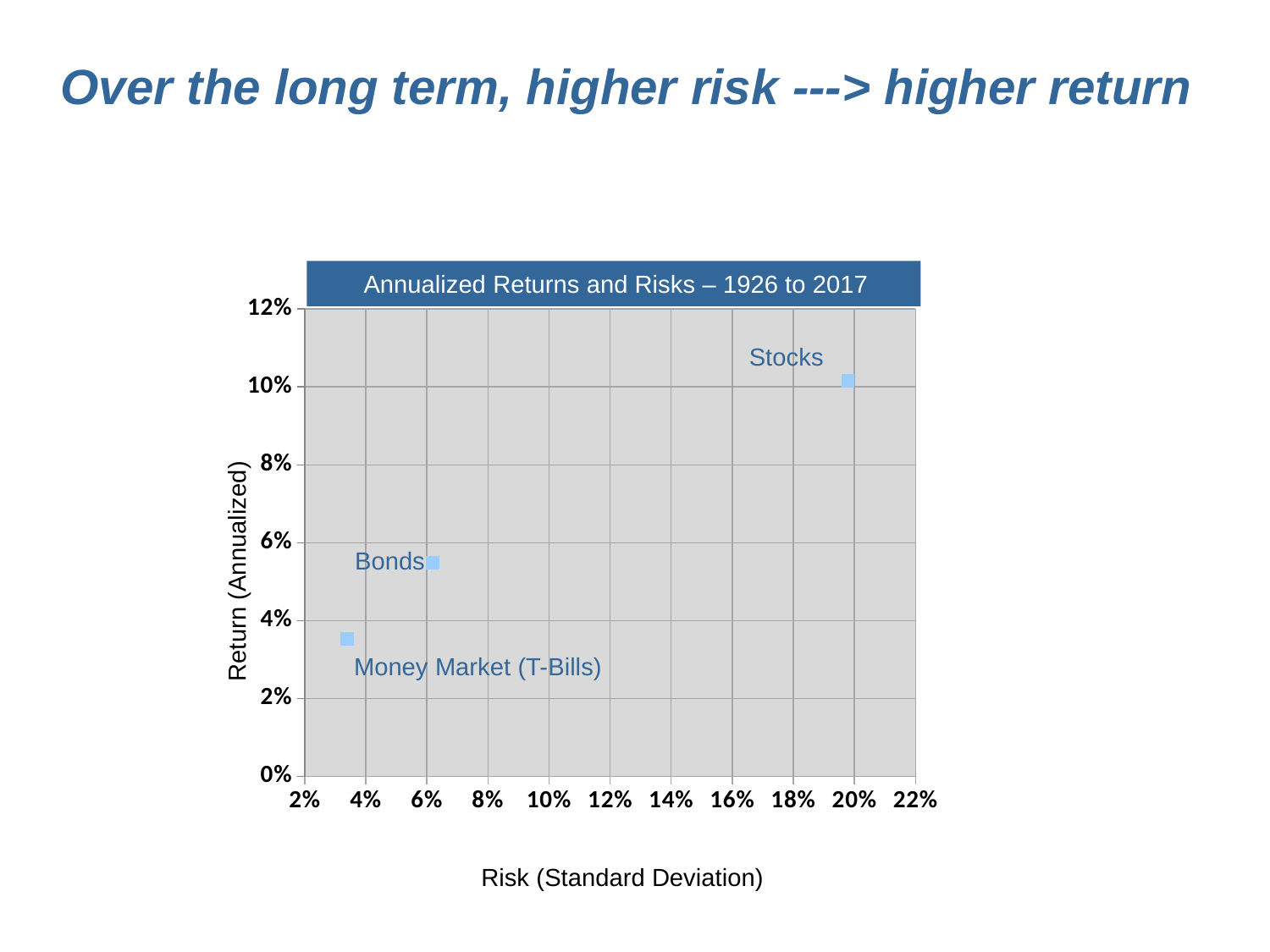
What kind of chart is shown on the slide? scatter chart Which asset class has the lowest annualized return? Money Market (T-Bills) How many data points are plotted on the chart? 3 Which asset class has the highest annualized return? Stocks Is the annualized return for Bonds greater or less than 6%? less As risk increases along the x axis, does annualized return rise or fall? rise Which asset class has the lowest risk (standard deviation)? Money Market (T-Bills) Which has a higher annualized return, Bonds or Money Market (T-Bills)? Bonds Is the risk (standard deviation) for Stocks greater or less than 18%? greater What is the title of the chart? Annualized Returns and Risks – 1926 to 2017 Which asset class has the highest risk (standard deviation)? Stocks